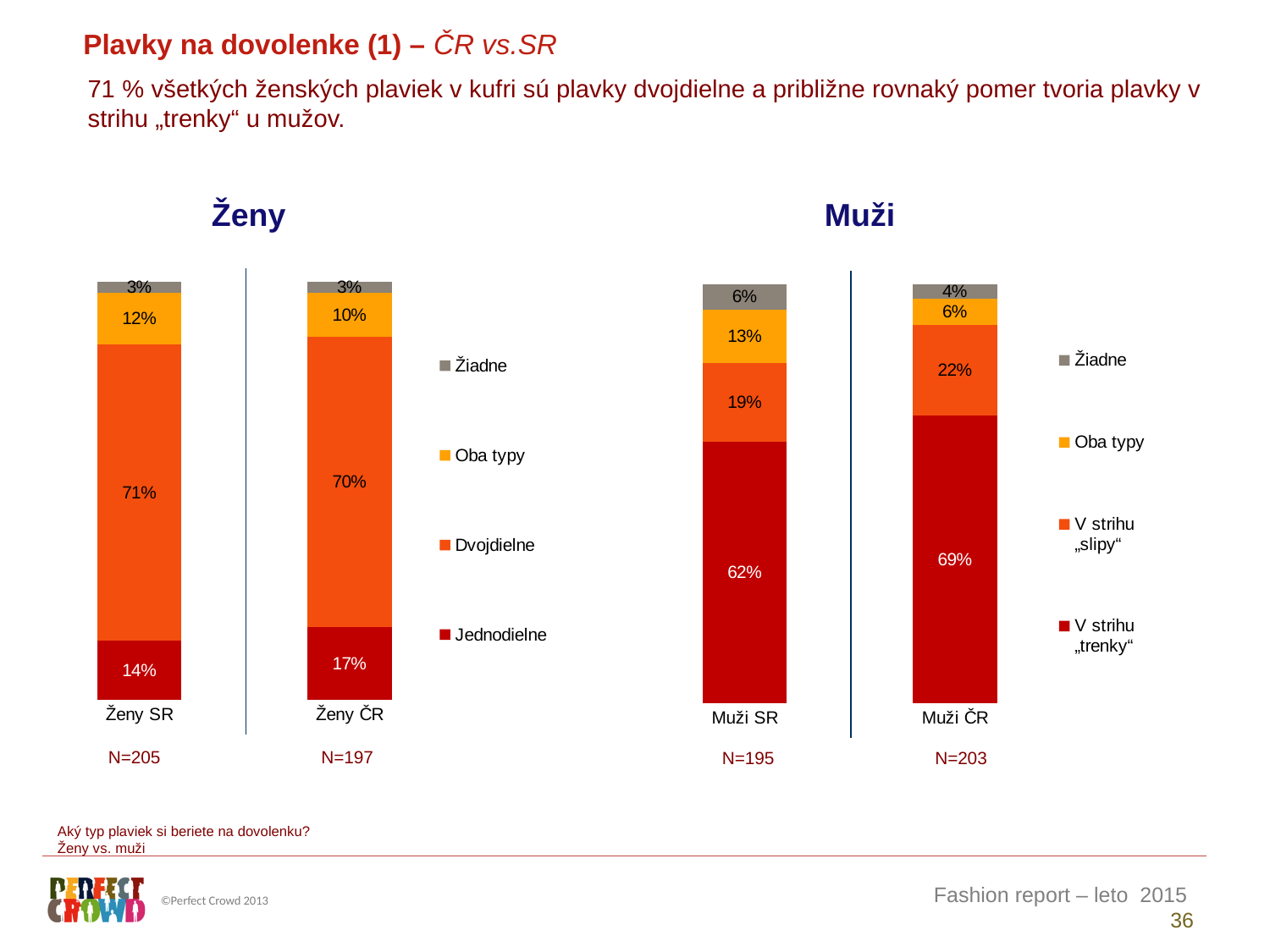
In the Muži chart, what is the difference between the V strihu „slipy“ values for Muži ČR and Muži SR? 3% In the Ženy chart, which segment is the largest for Ženy ČR? Dvojdielne In the Ženy chart, what is the Dvojdielne value for Ženy SR? 71% In the Muži chart, what is the Oba typy value for Muži SR? 13% In the Muži chart, what is the Žiadne value for Muži ČR? 4% In the Muži chart, what is the V strihu „trenky“ value for Muži ČR? 69% In the Ženy chart, what is the Jednodielne value for Ženy ČR? 17% In the Ženy chart, which is larger: the Oba typy value for Ženy SR or for Ženy ČR? Ženy SR In the Muži chart, which segment is the smallest for Muži SR? Žiadne What type of chart is the Ženy chart? Stacked bar chart What is the sample size (N) shown for Muži SR? N=195 How many series does the legend of the Muži chart list? 4